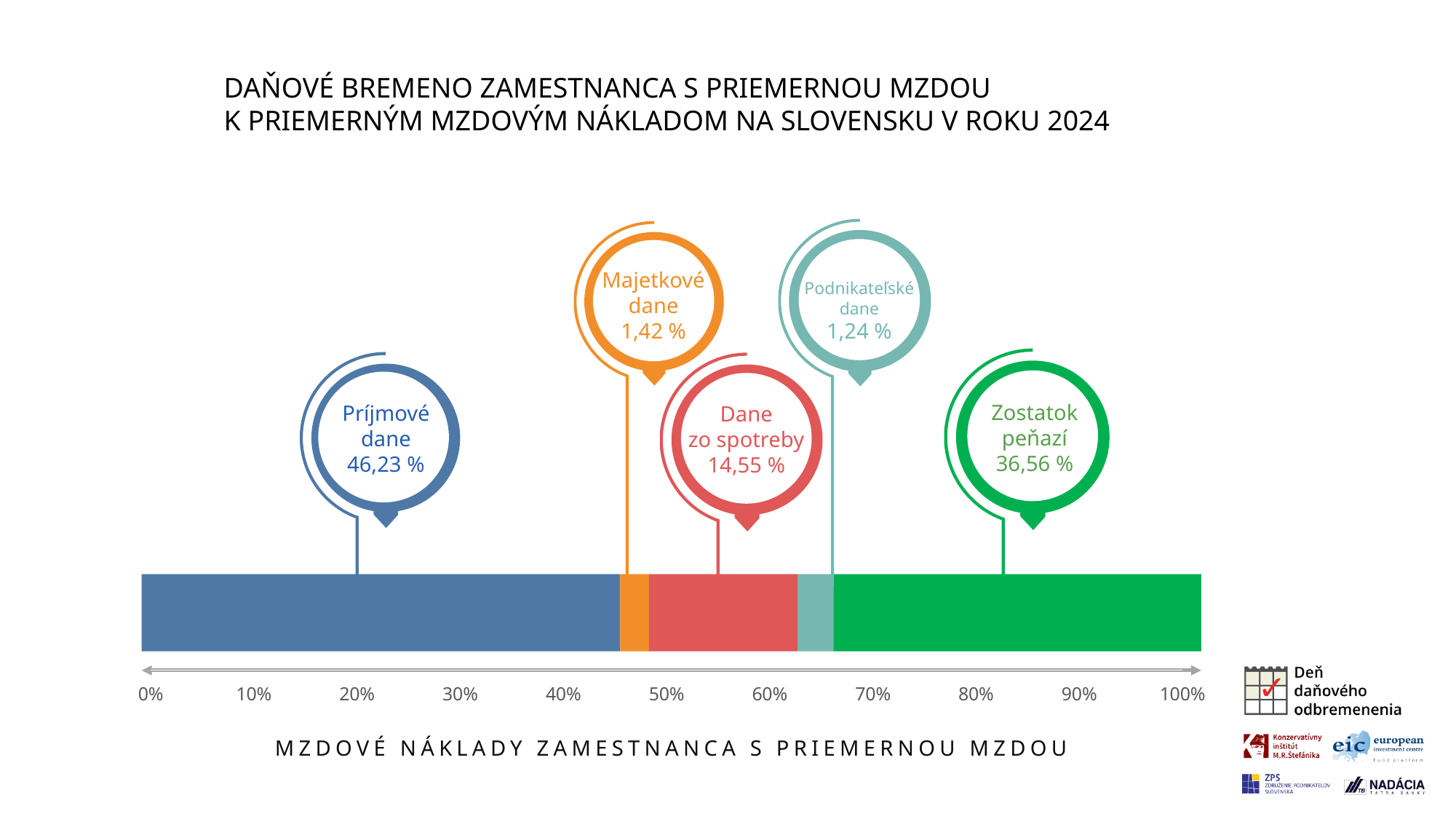
What is the value for Zostatok peňazí? 36,56 % What is the value for Príjmové dane? 46,23 % Is the value for Príjmové dane greater or less than 40%? greater What kind of chart is shown on the slide? Stacked bar chart Which is larger, Dane zo spotreby or Zostatok peňazí? Zostatok peňazí How many segments does the bar have? 5 Which segment has the lowest value? Podnikateľské dane What is the difference between Príjmové dane and Zostatok peňazí? 9,67 % Which segment has the highest value? Príjmové dane What is the value for Dane zo spotreby? 14,55 % What is the value for Majetkové dane? 1,42 % What is the total of all segments in the bar? 100,00 %